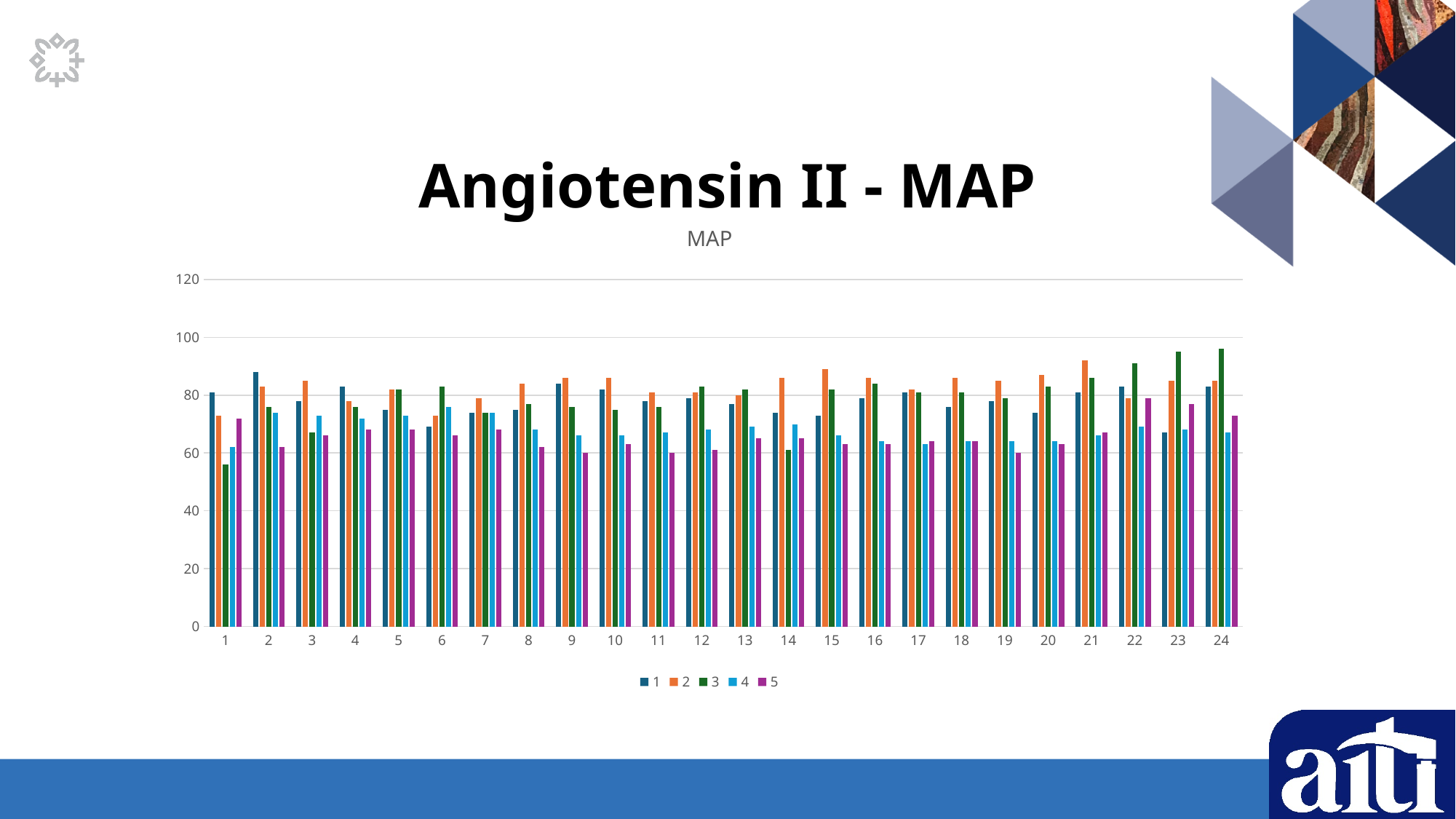
Is the value for series 3 at category 24 greater or less than 80? greater Which series has the lowest value at category 1? 3 Which colour represents series 2 in the chart? orange Is the value for series 3 at category 14 greater or less than 80? less What type of chart is shown on the slide? bar chart What is the title of the chart? MAP Which series has the highest value at category 24? 3 How many series does the legend of the MAP chart list? 5 Is the value for series 3 at category 1 greater or less than 60? less How many categories are shown on the x axis of the MAP chart? 24 At category 1, which is larger: the value for series 1 or the value for series 3? series 1